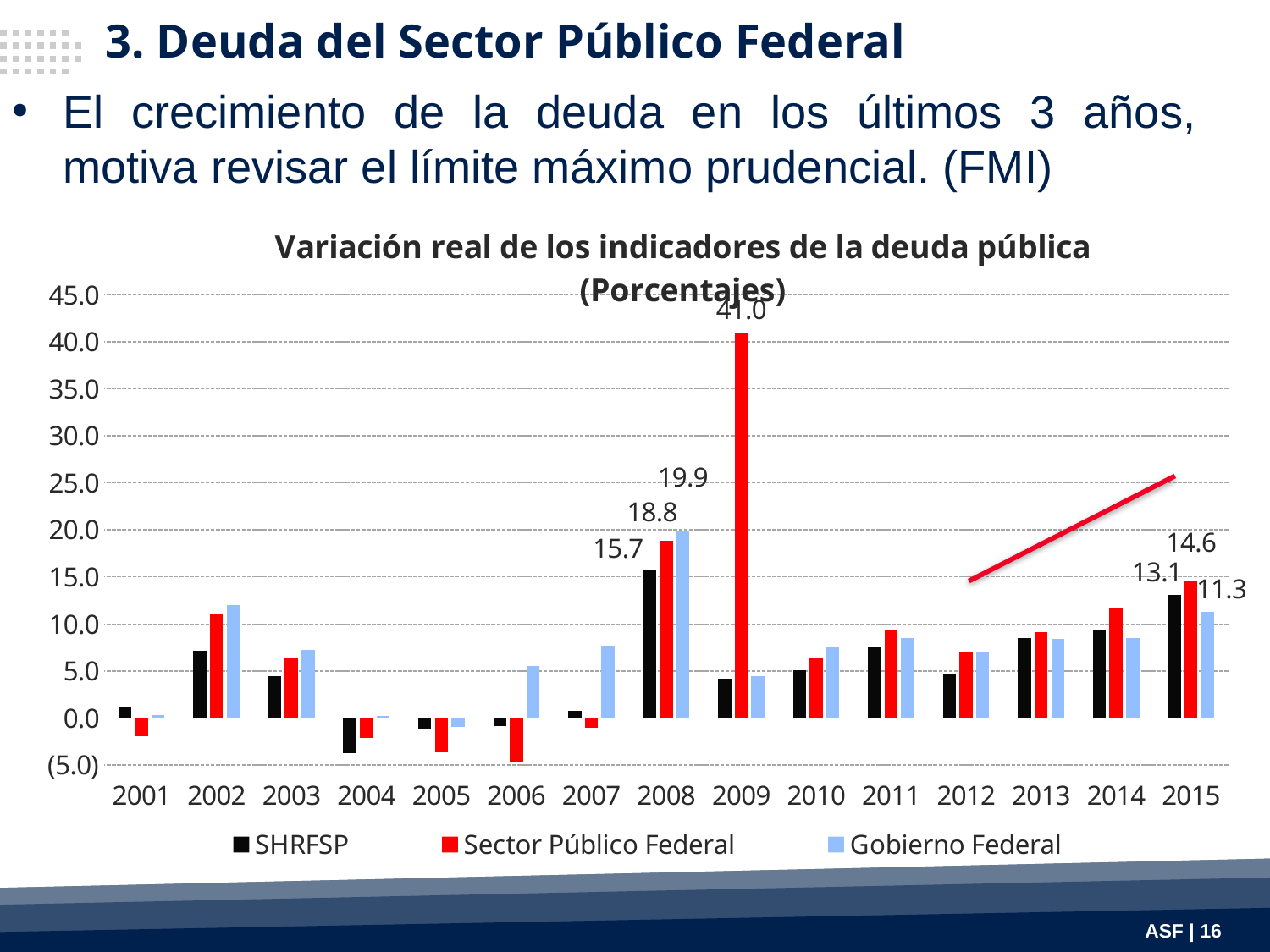
What is the value for Sector Público Federal in 2009? 41.0 What is the value for Sector Público Federal in 2015? 14.6 In 2008, which is larger: Sector Público Federal or Gobierno Federal? Gobierno Federal How many years are shown on the x axis? 15 Is the value for Sector Público Federal in 2006 greater or less than 0.0? less In which year does the Sector Público Federal series reach its highest value? 2009 What is the difference between the Sector Público Federal and Gobierno Federal values in 2015? 3.3 What kind of chart is shown on the slide? bar chart What is the difference between the Gobierno Federal and SHRFSP values in 2008? 4.2 What is the value for Gobierno Federal in 2015? 11.3 How many series does the legend list? 3 What is the value for SHRFSP in 2008? 15.7